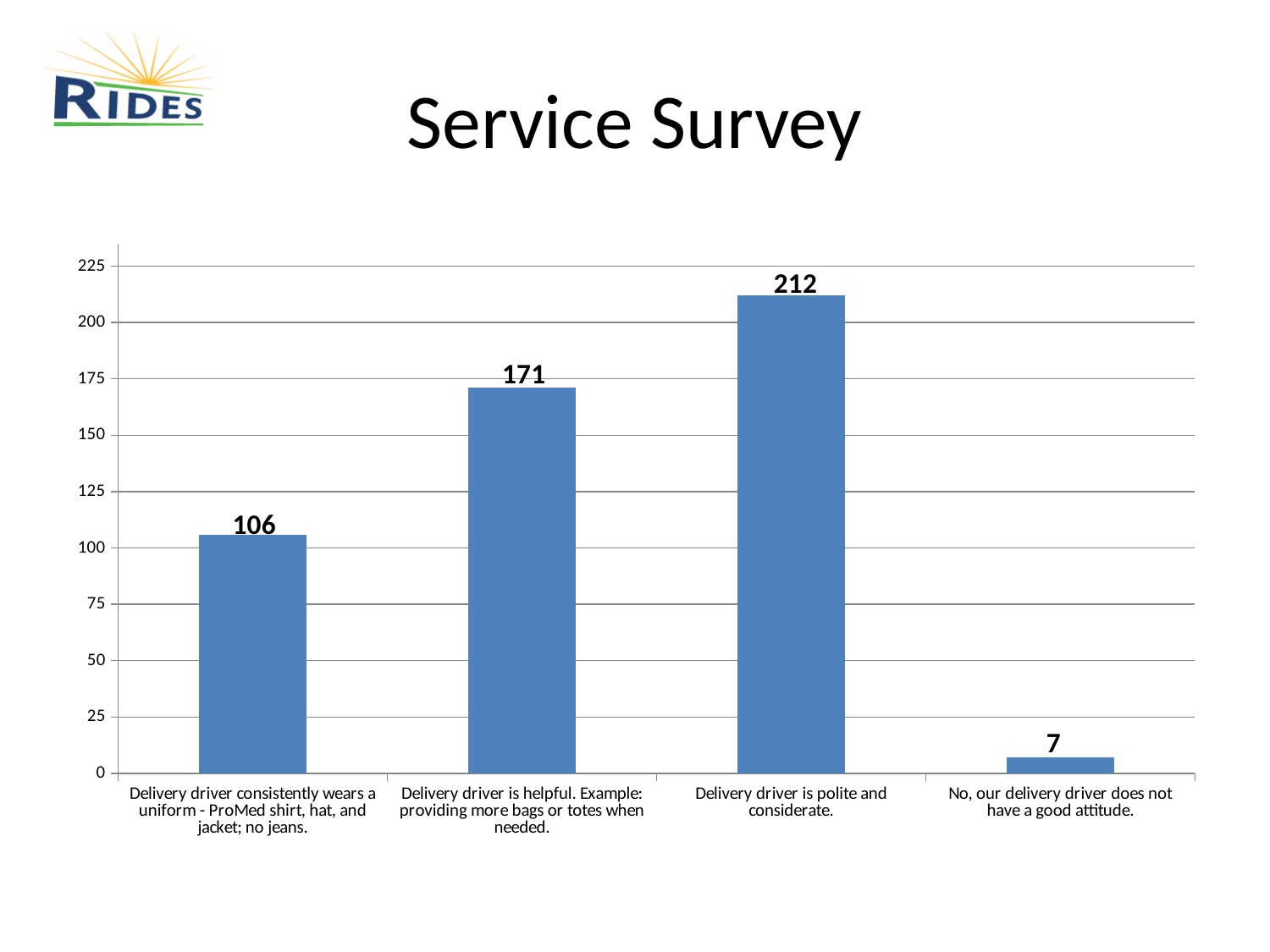
Which is larger: the value for "Delivery driver is helpful. Example: providing more bags or totes when needed." or the value for "Delivery driver consistently wears a uniform - ProMed shirt, hat, and jacket; no jeans."? Delivery driver is helpful. Example: providing more bags or totes when needed. What is the difference between the values for "Delivery driver consistently wears a uniform - ProMed shirt, hat, and jacket; no jeans." and "No, our delivery driver does not have a good attitude."? 99 Which category has the highest value? Delivery driver is polite and considerate. What is the value for "No, our delivery driver does not have a good attitude."? 7 Which category has the lowest value? No, our delivery driver does not have a good attitude. What kind of chart is shown on the slide? bar chart How many categories are shown in the chart? 4 What is the difference between the values for "Delivery driver is polite and considerate." and "Delivery driver is helpful. Example: providing more bags or totes when needed."? 41 What is the value for "Delivery driver is polite and considerate."? 212 What is the value for "Delivery driver is helpful. Example: providing more bags or totes when needed."? 171 What is the value for "Delivery driver consistently wears a uniform - ProMed shirt, hat, and jacket; no jeans."? 106 Is the value for "Delivery driver is polite and considerate." greater or less than 200? greater